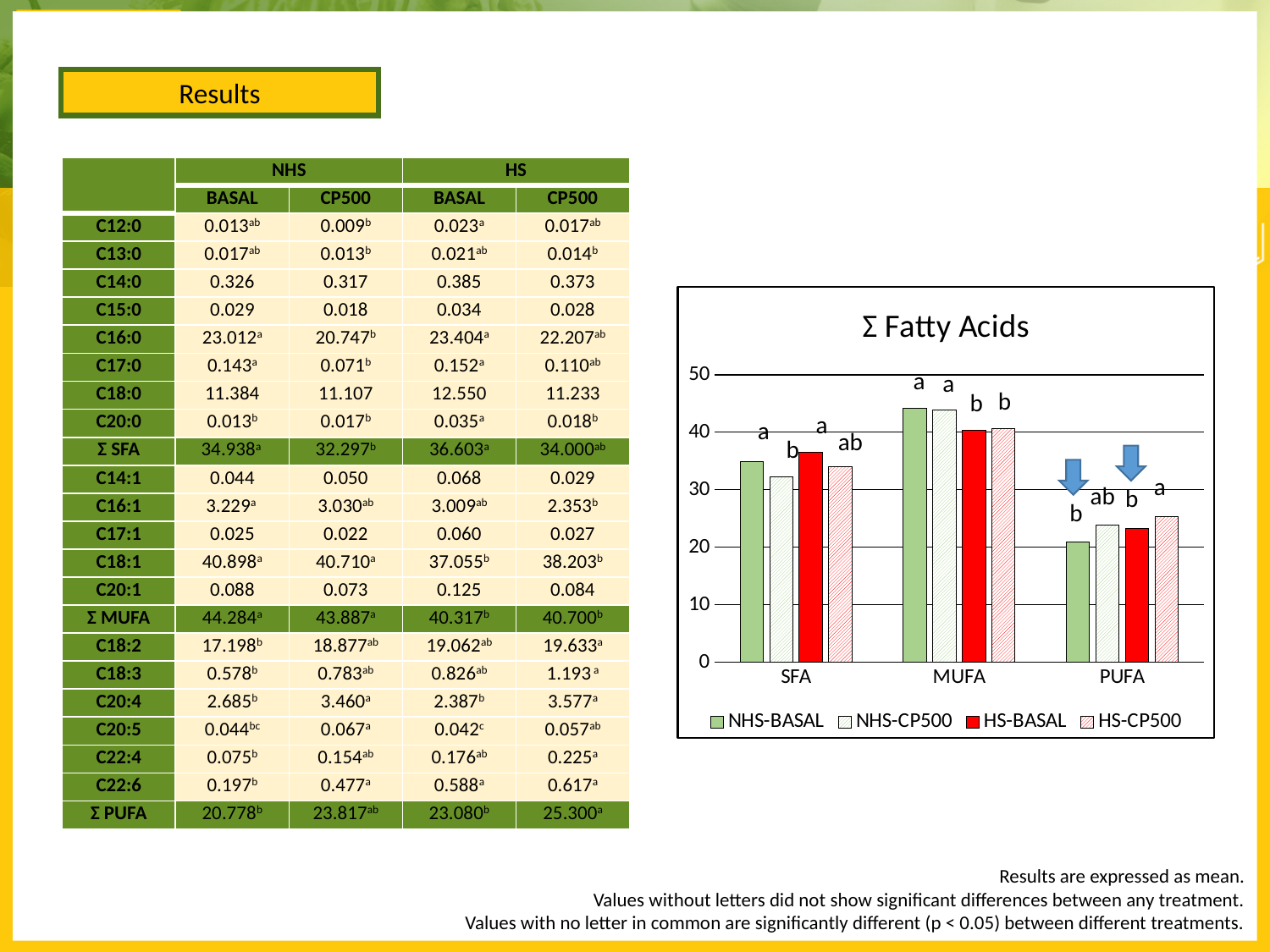
Within the PUFA category, which series has the lowest bar? NHS-BASAL Which category has the lowest NHS-BASAL bar in the chart? PUFA Is the NHS-BASAL value for MUFA greater or less than 40? greater Is the HS-CP500 value for PUFA greater or less than 30? less How many categories are shown on the x axis of the chart? 3 Which is larger in the PUFA category: the NHS-BASAL bar or the HS-CP500 bar? HS-CP500 What type of chart is shown on the slide? bar chart Which category has the highest NHS-BASAL bar in the chart? MUFA Is the HS-BASAL value for SFA greater or less than 30? greater What is the title of the chart? Σ Fatty Acids Which series is drawn in solid red in the chart? HS-BASAL How many series does the chart legend list? 4